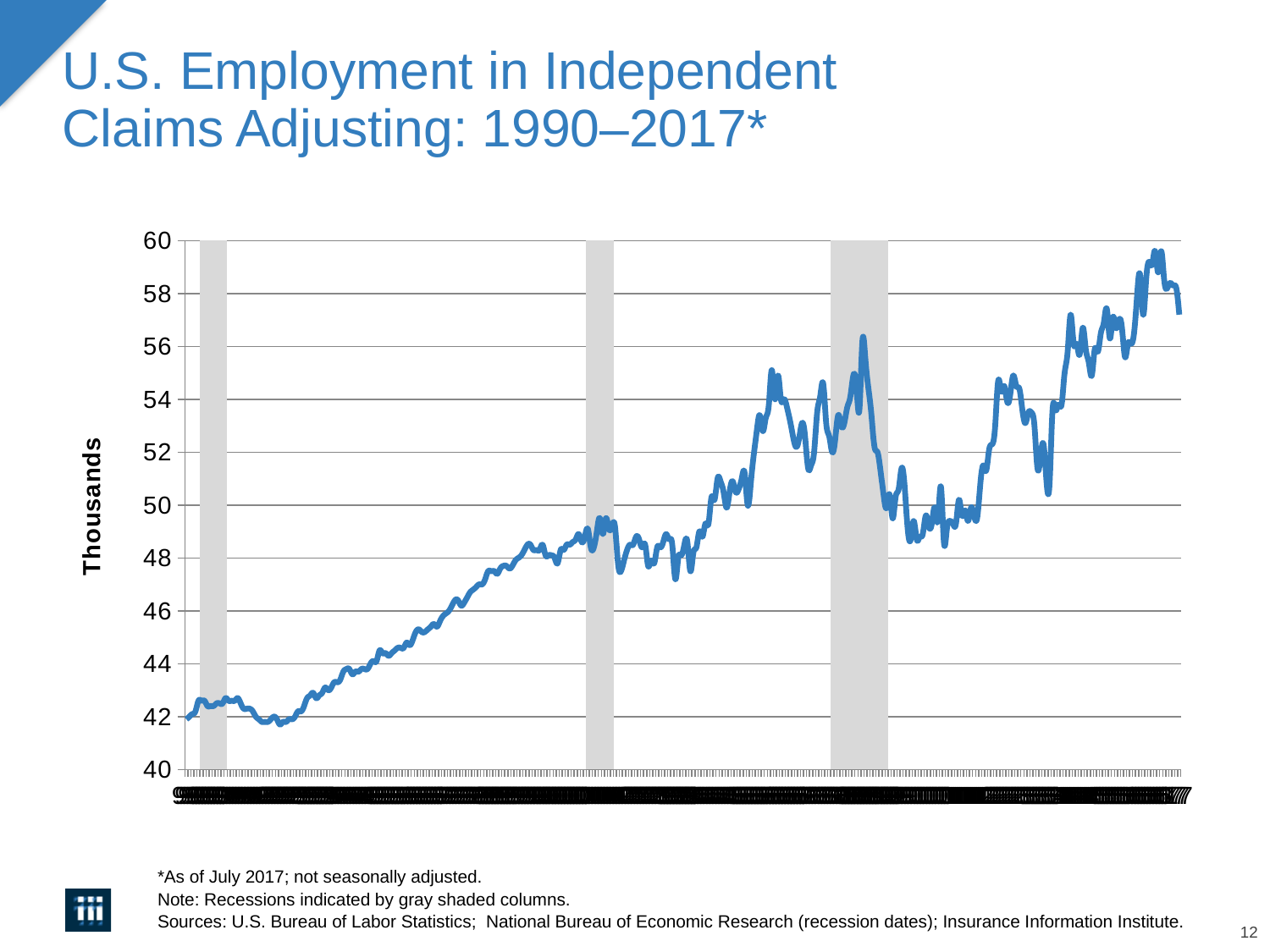
Overall, does the line rise or fall from the left end of the chart to the right end? rise What is the label on the vertical axis of the chart? Thousands Is the value at the start of the line (left end) greater or less than 44? less What is the title of the chart on the slide? U.S. Employment in Independent Claims Adjusting: 1990–2017* What is the highest value shown on the vertical axis? 60 Is the value at the end of the line (right end) greater or less than 56? greater Which is larger, the value at the left end of the line or the value at the right end of the line? the right end Is the lowest point of the line greater or less than 44? less How many lines are plotted on the chart? 1 How many gray shaded recession columns appear on the chart? 3 What kind of chart is shown on the slide? line chart